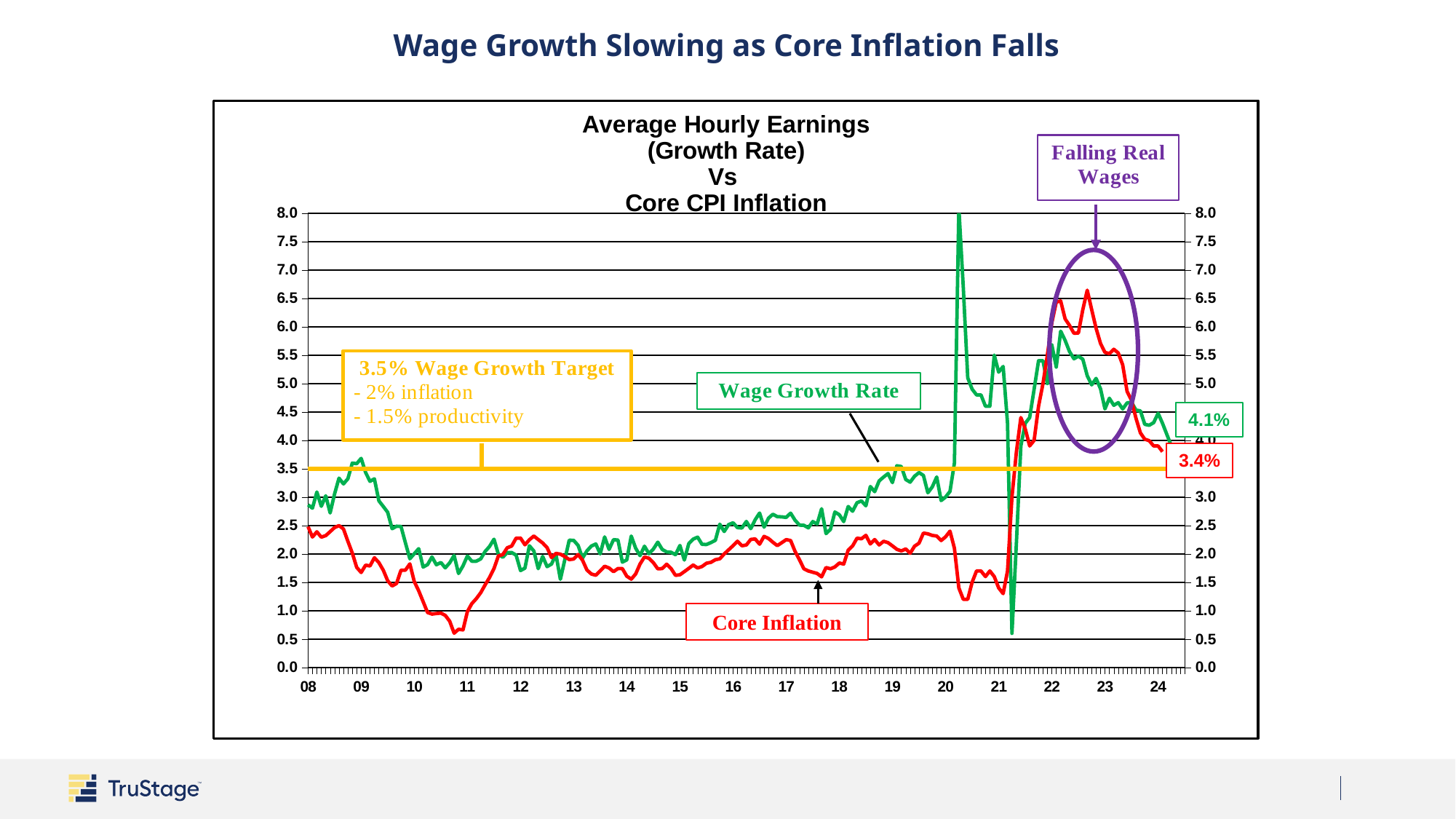
Is the peak of the Wage Growth Rate line around 2020 greater or less than 7.0? greater Is the lowest point of the Core Inflation line around 2011 greater or less than 1.0? less What kind of chart is shown on the slide? line chart Is the peak of the Core Inflation line around 2022 greater or less than 6.0? greater What is the latest labelled value of the Core Inflation line? 3.4% What value is the horizontal yellow Wage Growth Target line set at? 3.5% Does the Core Inflation line rise or fall from its 2022 peak to 2024? fall At the end of the chart, which is larger: the labelled Wage Growth Rate or the labelled Core Inflation? Wage Growth Rate What is the difference between the latest labelled Wage Growth Rate (4.1%) and the latest labelled Core Inflation (3.4%)? 0.7% How many data series (lines) are plotted on the chart, excluding the target line? 2 What is the latest labelled value of the Wage Growth Rate line? 4.1%